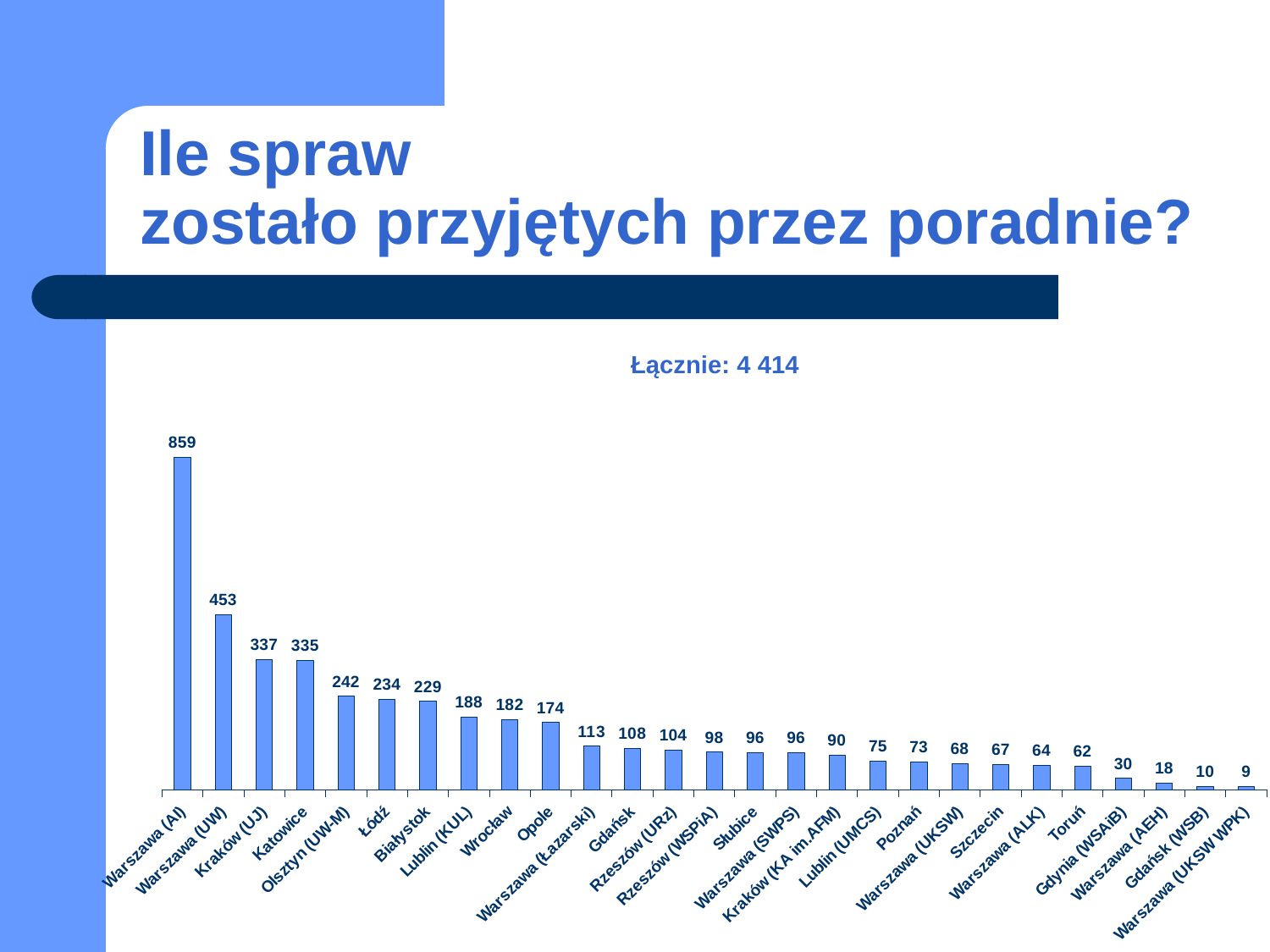
Which is larger, the value for Łódź or the value for Białystok? Łódź Which category has the highest value? Warszawa (AI) What is the value for Warszawa (UW)? 453 What is the value for Olsztyn (UW-M)? 242 How many categories are shown in the chart? 27 What kind of chart is shown on the slide? Bar chart What is the difference between the values for Lublin (KUL) and Wrocław? 6 What is the value for Gdańsk? 108 What is the difference between the values for Warszawa (AI) and Warszawa (UW)? 406 What total is stated above the chart (Łącznie)? 4 414 Which is larger, the value for Poznań or the value for Lublin (UMCS)? Lublin (UMCS) Which category has the lowest value? Warszawa (UKSW WPK)